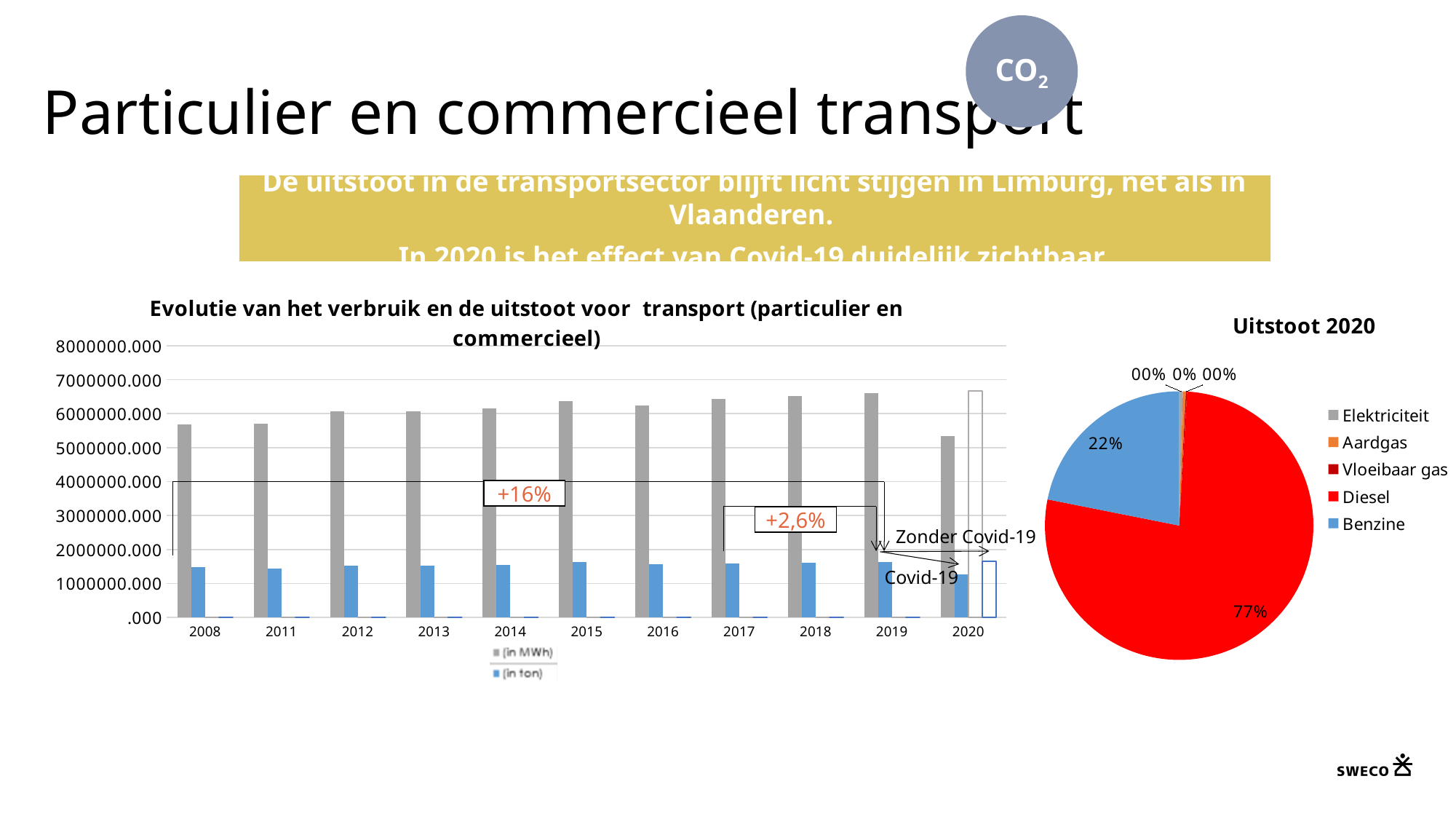
In the pie chart 'Uitstoot 2020', how many categories does the legend list? 5 In the bar chart on the left, is the '(in MWh)' value larger in 2019 or in 2020? 2019 In the bar chart on the left, is the value of the '(in MWh)' series for 2020 greater or less than 6000000.000? less In the bar chart on the left, how many years are shown on the x axis? 11 In the pie chart 'Uitstoot 2020', what share does Benzine have? 22% In the pie chart 'Uitstoot 2020', what share does Diesel have? 77% In the bar chart on the left, which year has the lowest value for the '(in MWh)' series? 2020 In the pie chart 'Uitstoot 2020', how many percentage points larger is the Diesel share than the Benzine share? 55 What kind of chart is the chart titled 'Evolutie van het verbruik en de uitstoot voor transport (particulier en commercieel)'? bar chart In the bar chart on the left, how many series does the legend list? 2 In the pie chart 'Uitstoot 2020', which category has the largest share? Diesel In the bar chart on the left, is the value of the '(in MWh)' series for 2019 greater or less than 6000000.000? greater